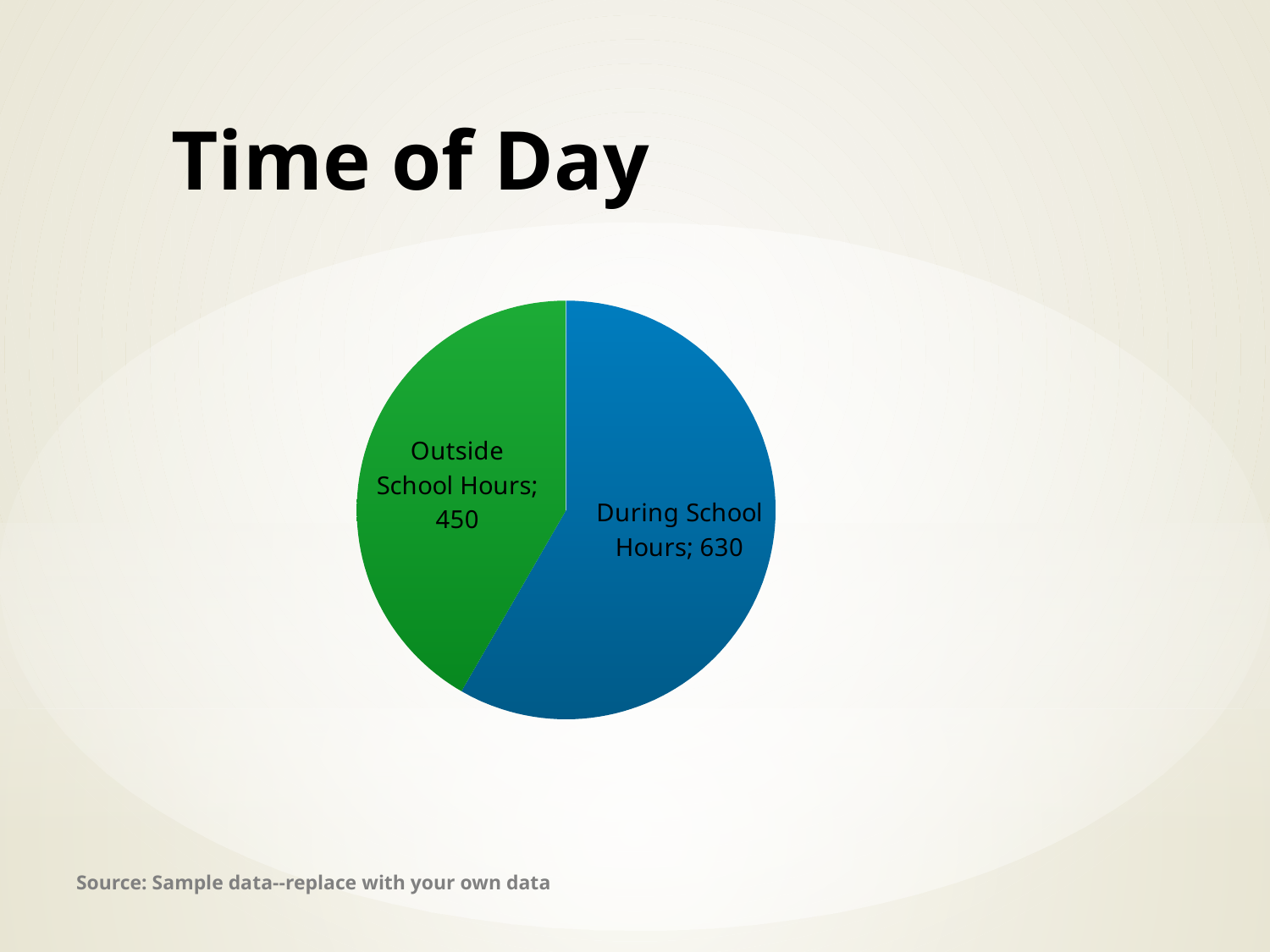
Which is larger, During School Hours or Outside School Hours? During School Hours What is the total of all slices in the pie chart? 1080 What kind of chart is shown on the slide? pie chart What is the difference between the During School Hours and Outside School Hours values? 180 What is the title of the chart? Time of Day How many slices does the pie chart have? 2 Which slice is the smallest? Outside School Hours Which slice is the largest? During School Hours What is the value for During School Hours? 630 What is the value for Outside School Hours? 450 What colour is the During School Hours slice? blue